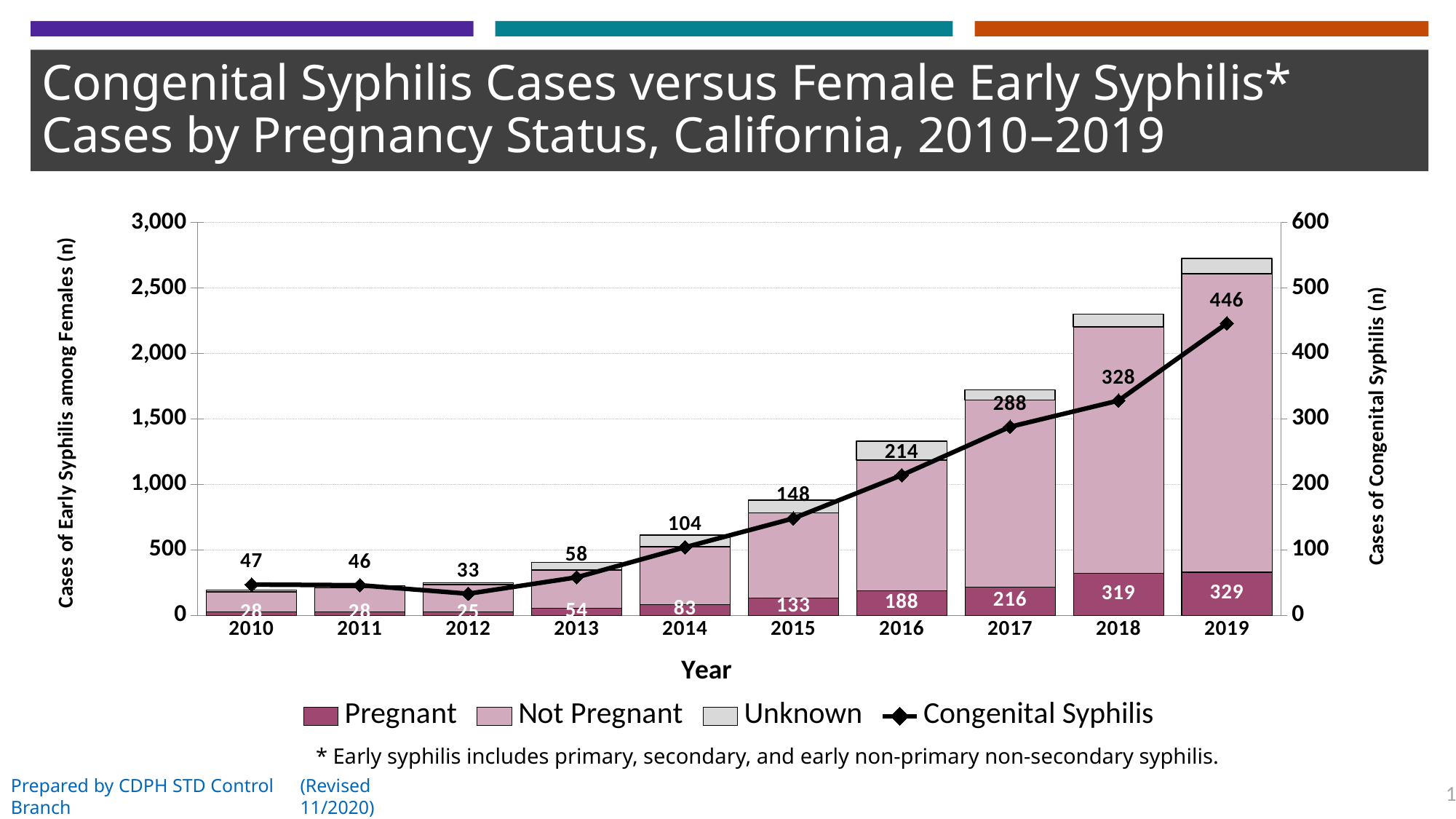
Which is larger: the congenital syphilis cases in 2015 or the Pregnant value in 2015? Congenital syphilis cases in 2015 (148) Which year has the lowest number of congenital syphilis cases? 2012 What is the difference in congenital syphilis cases between 2019 and 2018? 118 How many years are shown on the x axis? 10 Which year has the highest value for the Pregnant series? 2019 How many series does the legend list? 4 What is the difference between the Pregnant values for 2017 and 2016? 28 Does the congenital syphilis line generally rise or fall from 2012 to 2019? rise What is the value of the Pregnant series in 2018? 319 Is the total height of the stacked bar for 2019 greater or less than 2,500 on the left axis? greater How many congenital syphilis cases are shown for 2019? 446 How many congenital syphilis cases are shown for 2014? 104